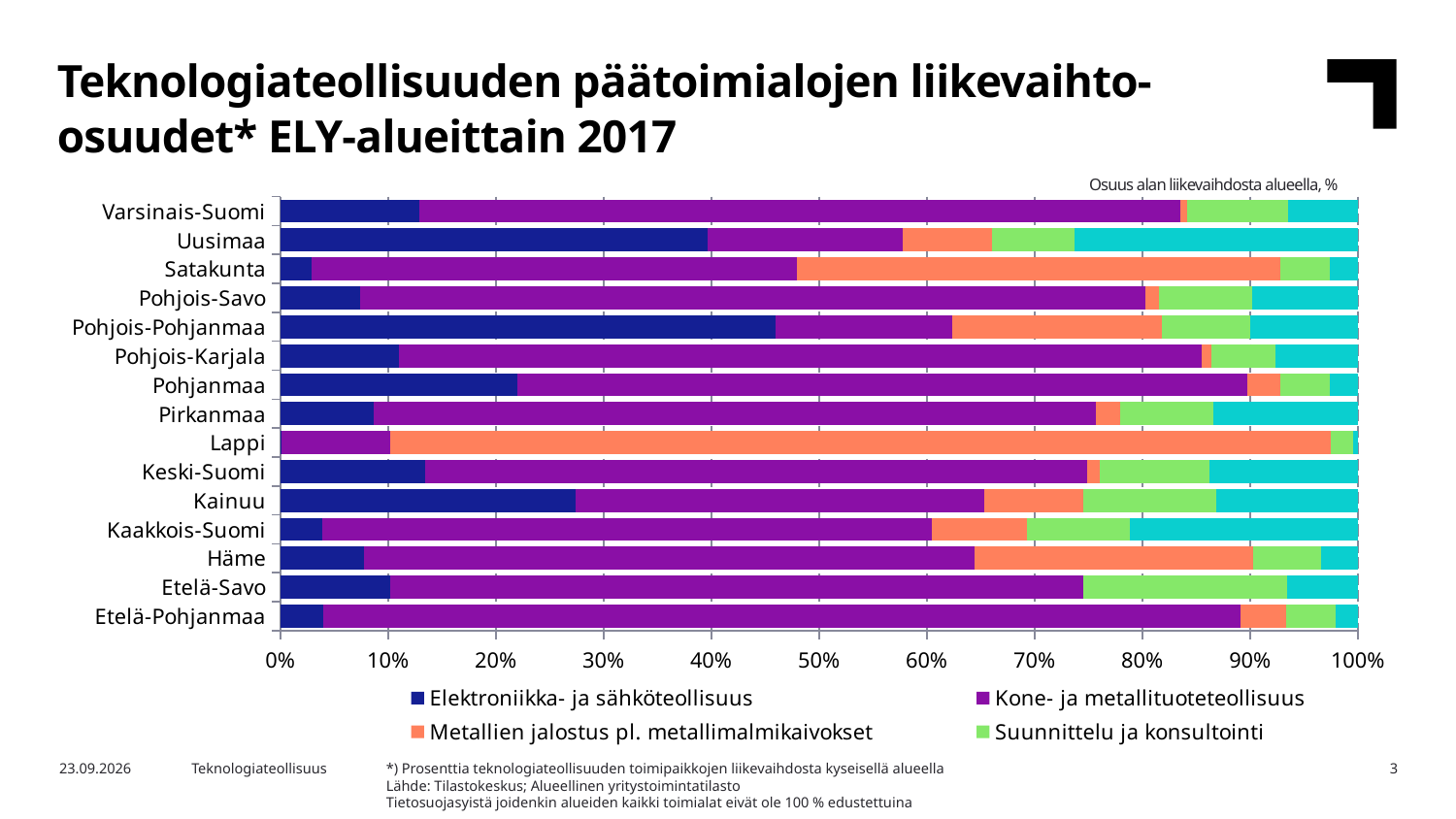
Is the Elektroniikka- ja sähköteollisuus share for Uusimaa greater or less than 30%? greater How many series does the chart legend list? 4 Is the Metallien jalostus pl. metallimalmikaivokset share for Lappi greater or less than 80%? greater Which region has the largest share for Metallien jalostus pl. metallimalmikaivokset? Lappi Which region has the larger Metallien jalostus pl. metallimalmikaivokset share, Satakunta or Pohjanmaa? Satakunta How many ELY regions are listed on the vertical axis of the chart? 15 Which region has the larger Elektroniikka- ja sähköteollisuus share, Uusimaa or Satakunta? Uusimaa What kind of chart is shown on the slide? Stacked bar chart Is the Elektroniikka- ja sähköteollisuus share for Kainuu greater or less than 20%? greater Which region has the largest share for Elektroniikka- ja sähköteollisuus? Pohjois-Pohjanmaa What is the title of the chart on the slide? Teknologiateollisuuden päätoimialojen liikevaihto-osuudet* ELY-alueittain 2017